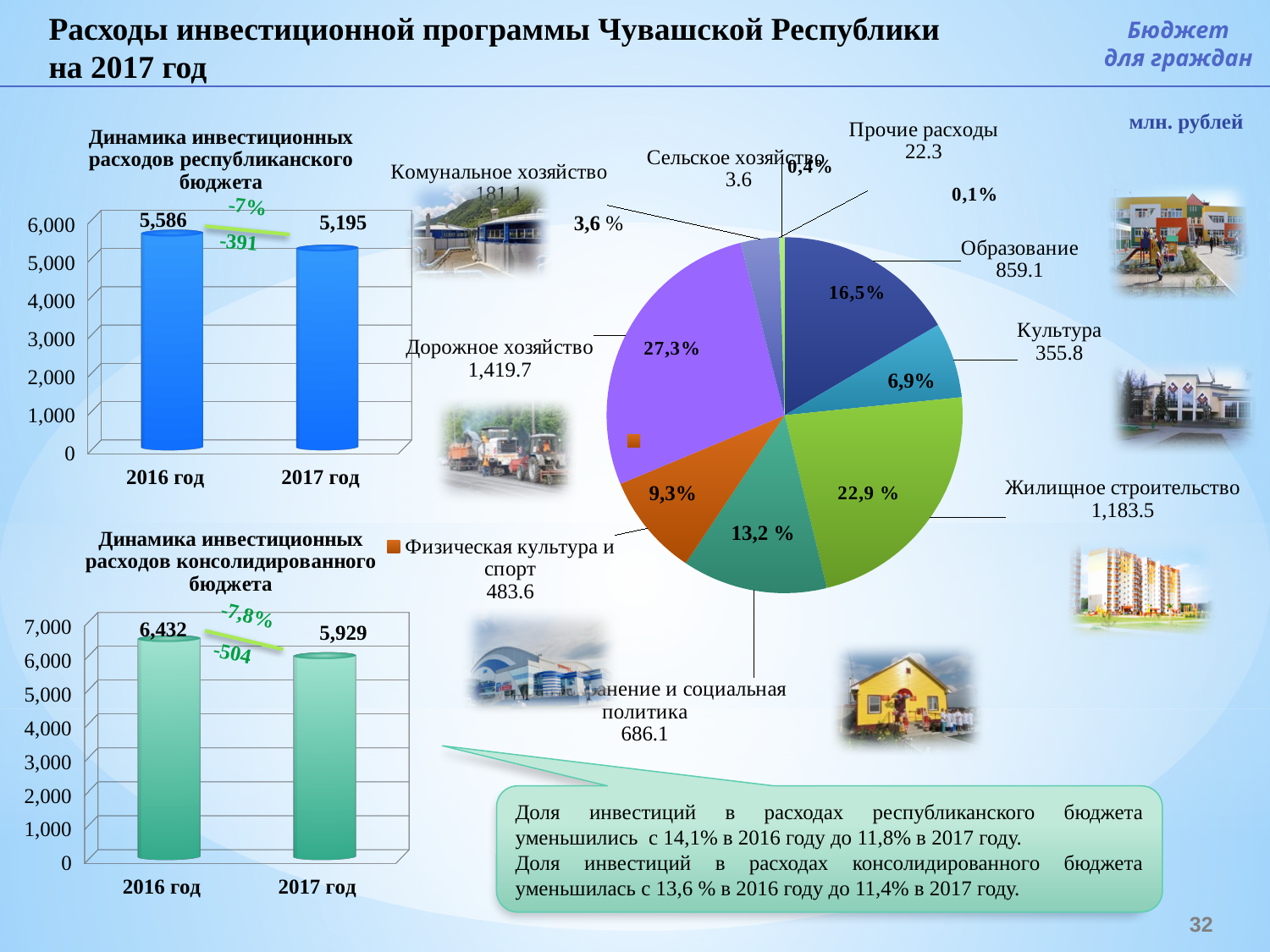
In the chart 'Динамика инвестиционных расходов консолидированного бюджета', what is the value for 2017 год? 5,929 In the chart 'Динамика инвестиционных расходов республиканского бюджета', what is the value for 2017 год? 5,195 In the chart 'Динамика инвестиционных расходов республиканского бюджета', what is the value for 2016 год? 5,586 In the pie chart, what is the value for Физическая культура и спорт? 483.6 What kind of chart is 'Динамика инвестиционных расходов консолидированного бюджета'? bar chart In the pie chart, which is larger: Образование or Культура? Образование In the pie chart, which category has the largest slice? Дорожное хозяйство In the pie chart, what is the value for Дорожное хозяйство? 1,419.7 In the pie chart, what share does Жилищное строительство have? 22,9 % In the chart 'Динамика инвестиционных расходов республиканского бюджета', what is the difference between the 2016 год and 2017 год values? 391 In the chart 'Динамика инвестиционных расходов консолидированного бюджета', do the values rise or fall from 2016 год to 2017 год? fall In the chart 'Динамика инвестиционных расходов консолидированного бюджета', what is the value for 2016 год? 6,432